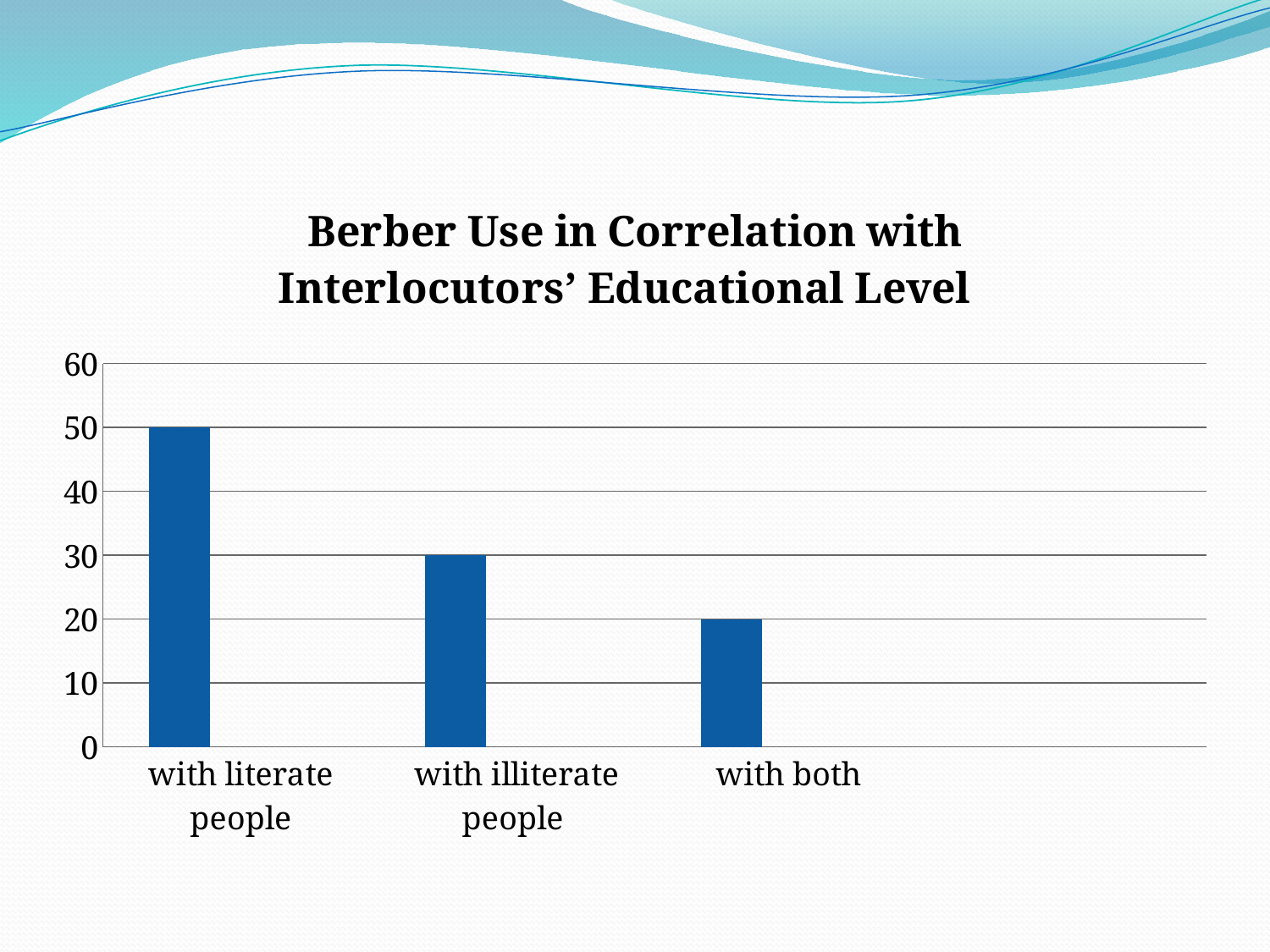
Which category has the lowest value? with both What is the difference between the values for 'with illiterate people' and 'with both'? 10 What is the value for 'with literate people'? 50 How many categories are shown on the x axis? 3 What is the value for 'with both'? 20 What is the title of the chart? Berber Use in Correlation with Interlocutors' Educational Level What kind of chart is shown on the slide? bar chart Which is larger, the value for 'with illiterate people' or the value for 'with both'? with illiterate people Which category has the highest value? with literate people What is the difference between the values for 'with literate people' and 'with illiterate people'? 20 Is the value for 'with literate people' greater or less than 40? greater What is the value for 'with illiterate people'? 30